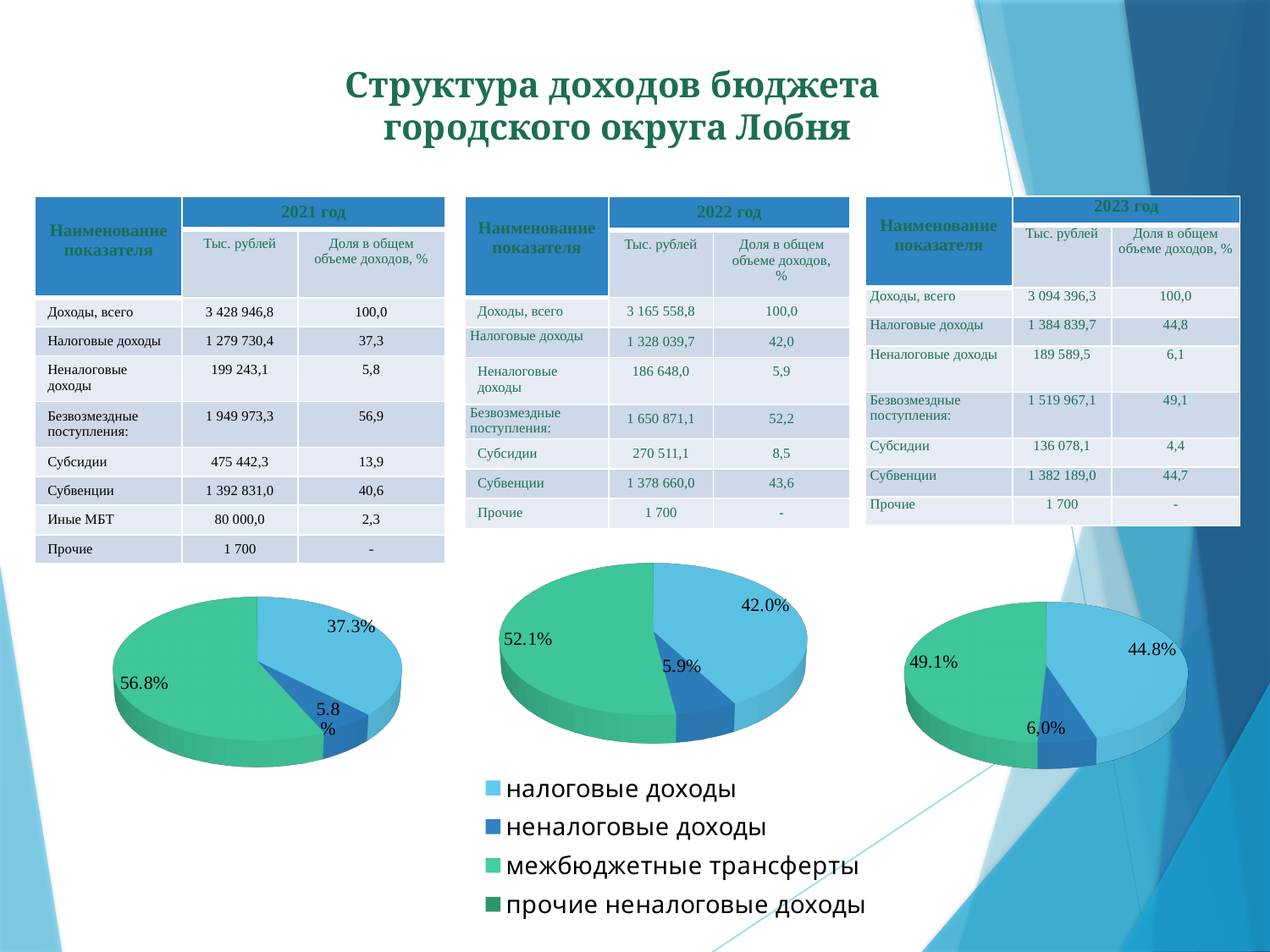
How many entries does the legend below the pie charts list? 4 How many pie charts are shown on the slide? 3 In the left pie chart, what share is labelled for налоговые доходы (light blue slice)? 37.3% In the right pie chart, what share is labelled for неналоговые доходы (blue slice)? 6,0% In the left pie chart, which category has the smallest labelled slice? неналоговые доходы In the left pie chart, what share is labelled for межбюджетные трансферты (green slice)? 56.8% What kind of chart is the left chart on the slide? pie chart In the right pie chart, which is larger: the share for налоговые доходы or the share for межбюджетные трансферты? межбюджетные трансферты In the right pie chart, which category has the largest slice? межбюджетные трансферты What colour does the legend use for межбюджетные трансферты? green In the middle pie chart, what share is labelled for неналоговые доходы (blue slice)? 5.9% In the middle pie chart, what is the difference between the shares for межбюджетные трансферты (52.1%) and налоговые доходы (42.0%)? 10.1 percentage points